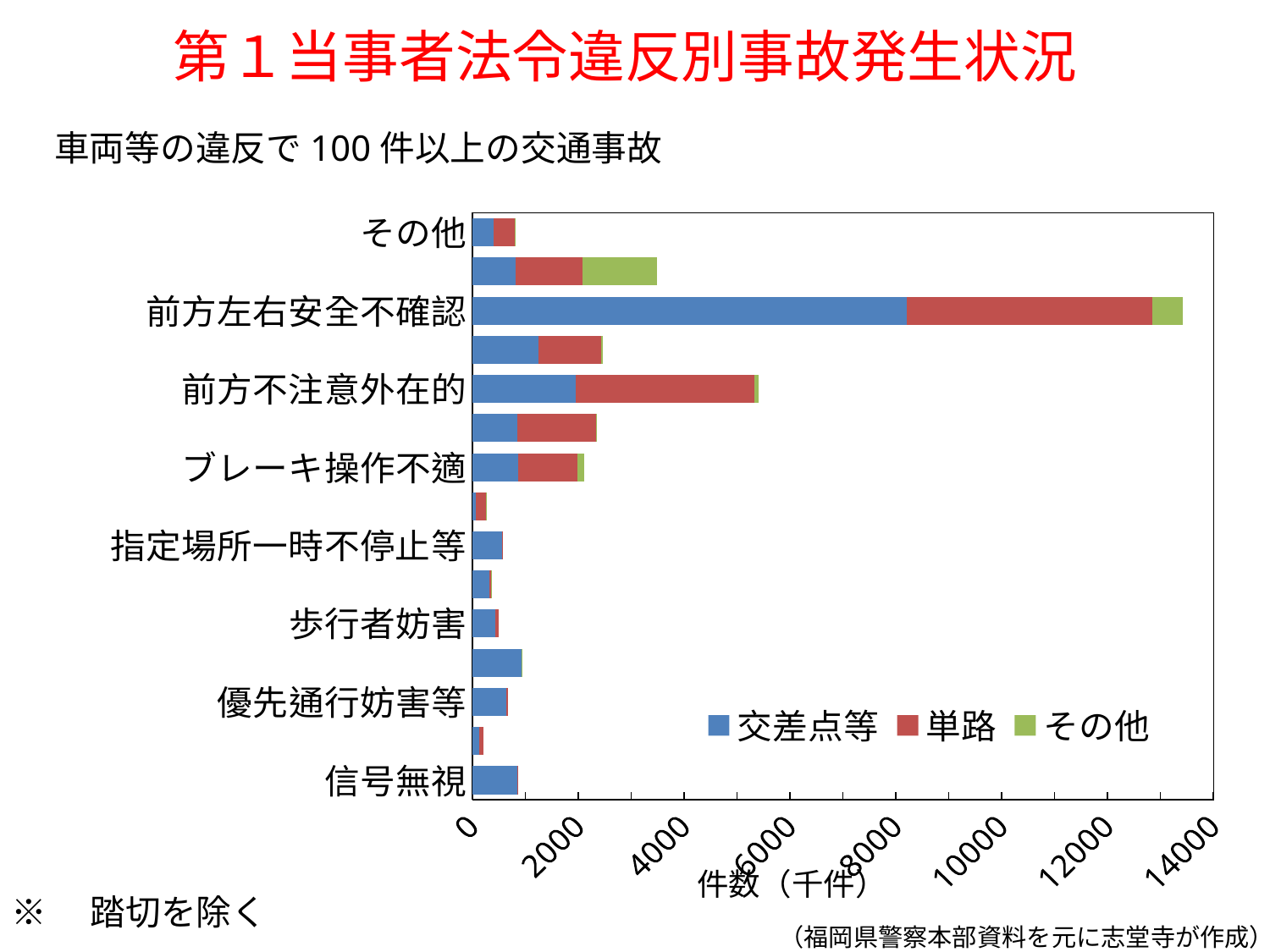
Is the total value for 前方不注意外在的 greater or less than 4000? greater How many series does the legend list? 3 Which has the larger total, 信号無視 or 歩行者妨害? 信号無視 Is the total value for 信号無視 greater or less than 2000? less Is the total value for ブレーキ操作不適 greater or less than 4000? less What kind of chart is shown on the slide? Stacked bar chart Which series are listed in the legend? 交差点等, 単路, その他 Which has the larger total, 前方不注意外在的 or ブレーキ操作不適? 前方不注意外在的 What is the title of the horizontal axis? 件数（千件） Which category has the longest bar? 前方左右安全不確認